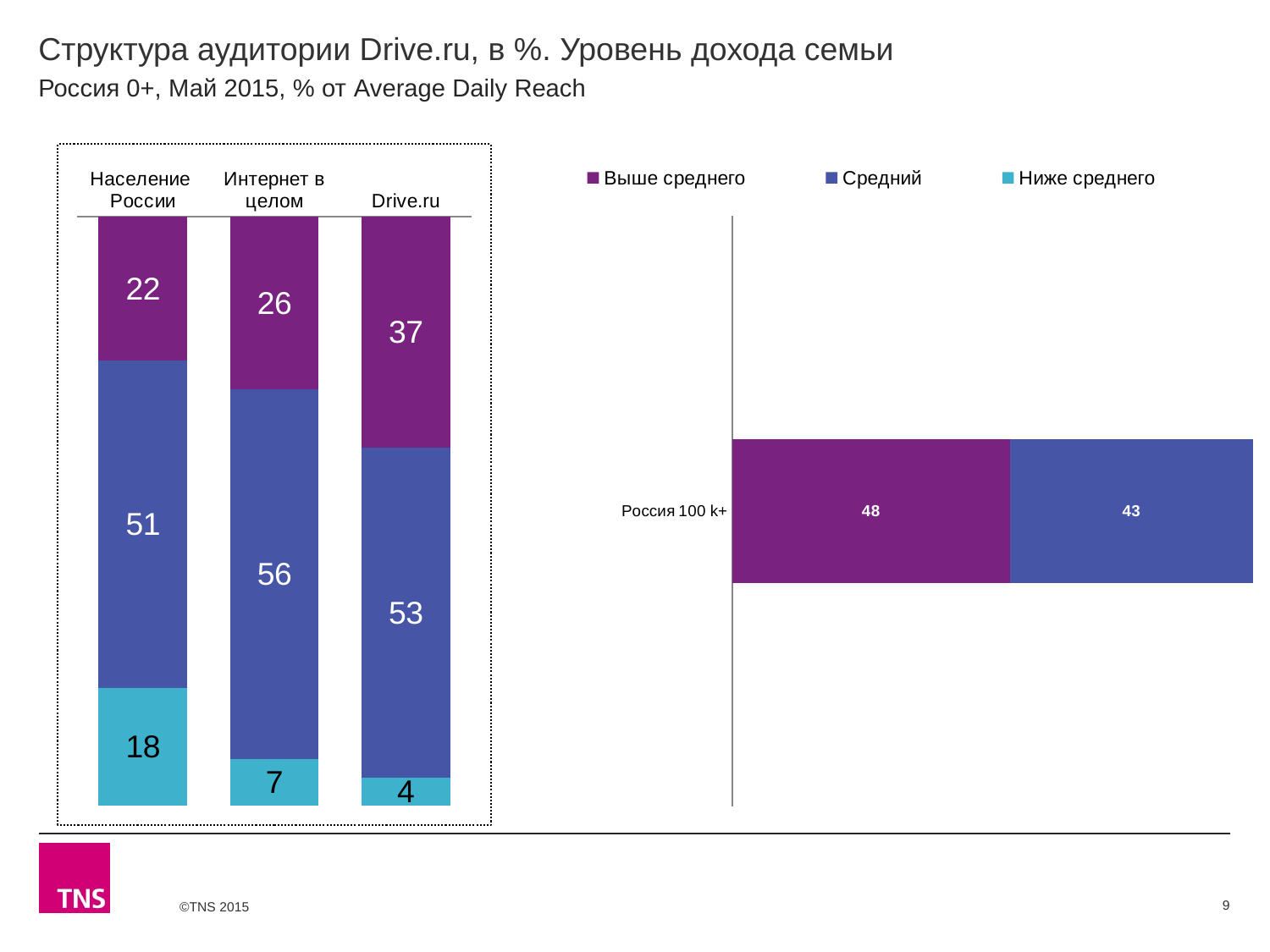
In the left chart, what is the difference between the Выше среднего values for Drive.ru and Население России? 15 In the left chart, what is the value of the Ниже среднего segment for Население России? 18 In the left chart, how many categories are shown on the x axis? 3 In the left chart, what is the value of the Выше среднего segment for Интернет в целом? 26 In the right chart, what is the Средний value for Россия 100 k+? 43 In the left chart, which is larger: the Средний value for Интернет в целом or for Население России? Интернет в целом In the left chart, what is the value of the Средний segment for Drive.ru? 53 How many series does the legend list? 3 In the left chart, which category has the lowest Ниже среднего value? Drive.ru In the left chart, which category has the highest Выше среднего value? Drive.ru What type of chart is the left chart? Stacked bar chart In the right chart, what is the Выше среднего value for Россия 100 k+? 48